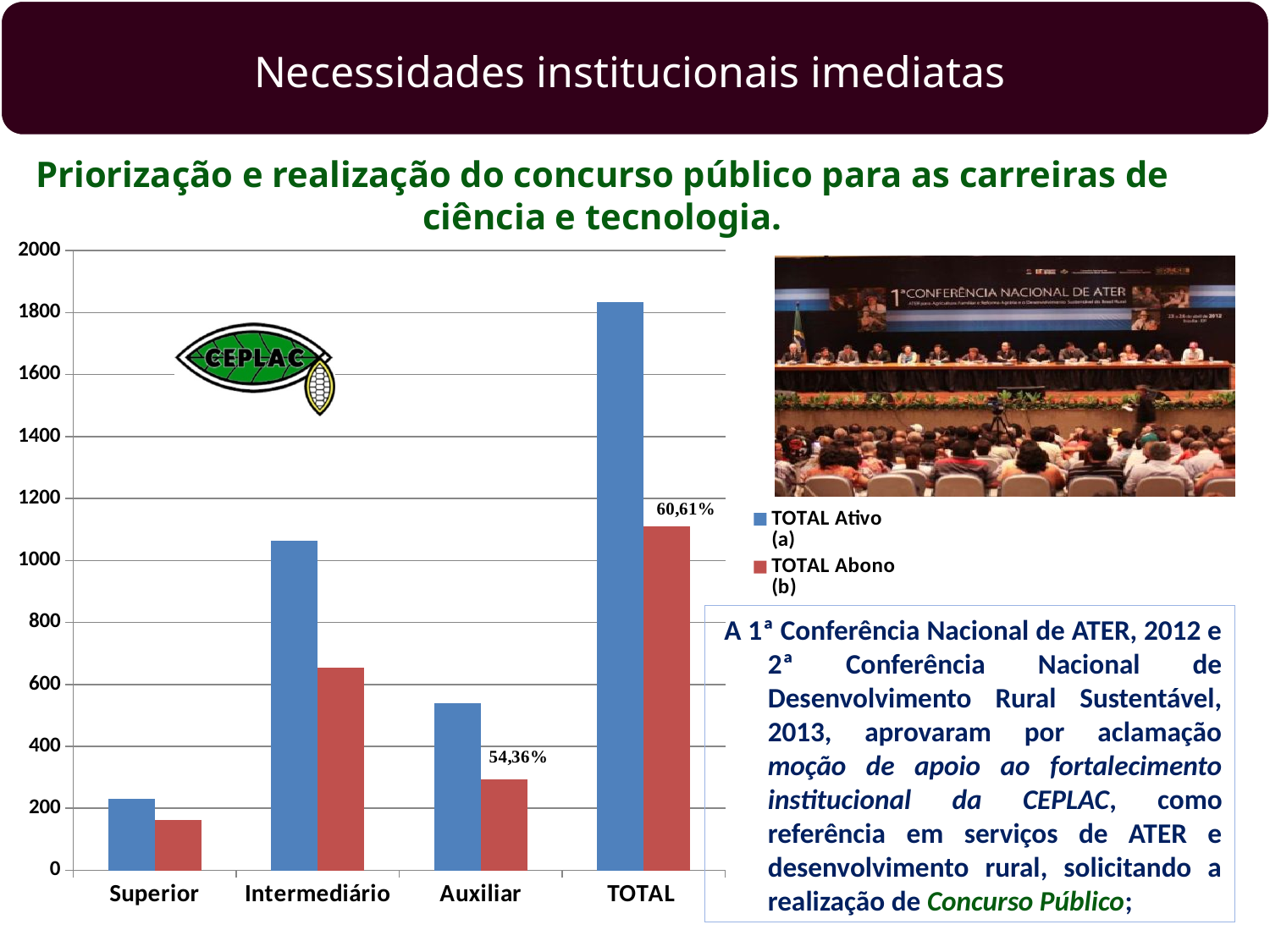
How many series does the chart's legend list? 2 How many categories are shown on the x axis of the chart? 4 What are the two legend entries of the chart? TOTAL Ativo (a) and TOTAL Abono (b) Which category has the tallest TOTAL Ativo (a) bar? TOTAL Is the TOTAL Ativo (a) value for TOTAL greater or less than 1600? greater Which is larger: the TOTAL Ativo (a) value for Intermediário or for Auxiliar? Intermediário Is the TOTAL Ativo (a) value for Intermediário greater or less than 1000? greater Is the TOTAL Abono (b) value for Superior greater or less than 200? less What kind of chart is shown on the slide? bar chart Which is larger: the TOTAL Abono (b) value for Intermediário or the TOTAL Ativo (a) value for Auxiliar? TOTAL Abono (b) for Intermediário Which category has the shortest TOTAL Abono (b) bar? Superior